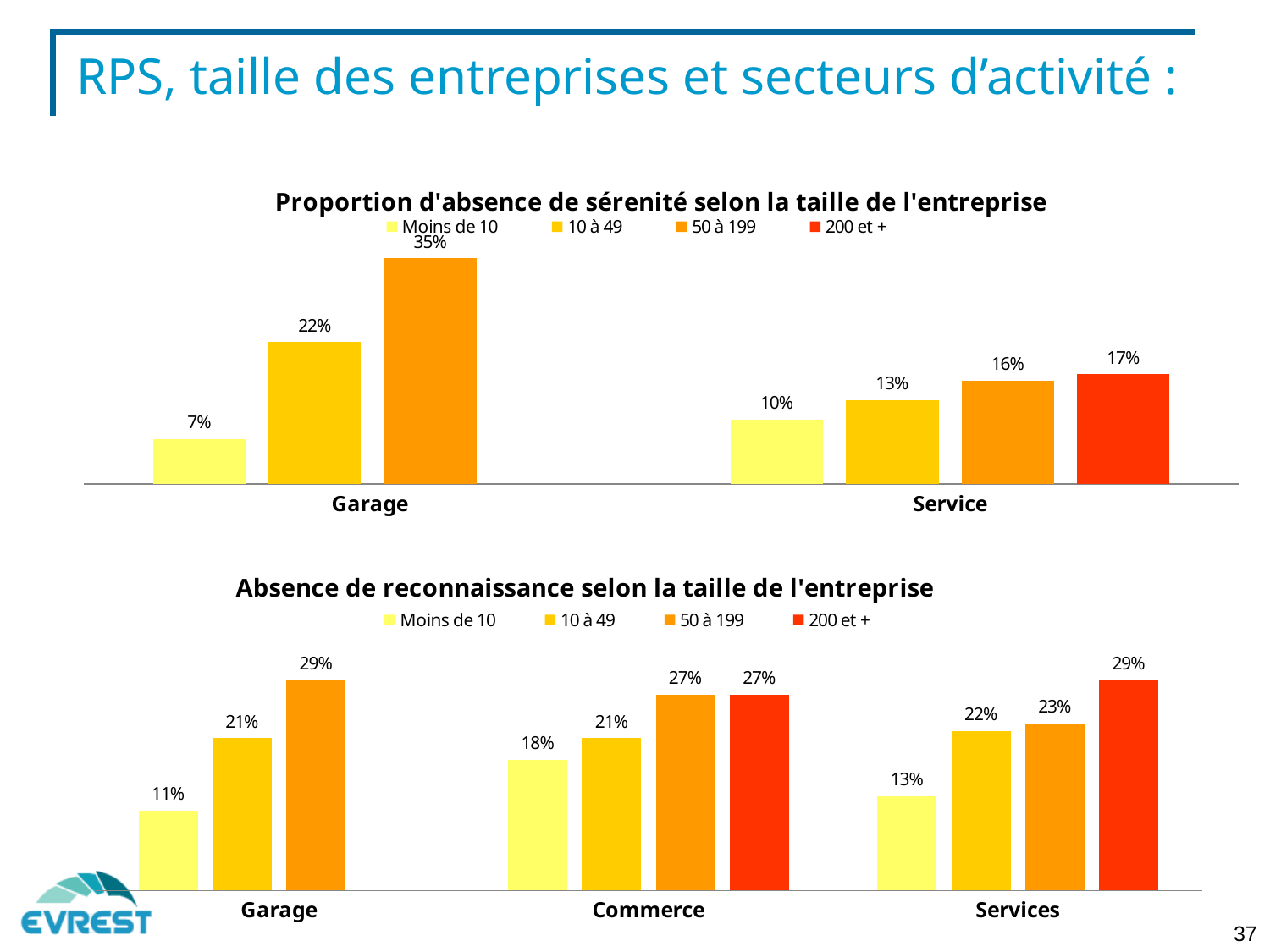
In the chart 'Absence de reconnaissance selon la taille de l'entreprise', what is the value for 'Moins de 10' in the Commerce category? 18% In the chart 'Absence de reconnaissance selon la taille de l'entreprise', what is the value for '200 et +' in the Services category? 29% In the chart 'Proportion d'absence de sérenité selon la taille de l'entreprise', what is the value for '50 à 199' in the Garage category? 35% In the chart 'Absence de reconnaissance selon la taille de l'entreprise', is the '50 à 199' value for Garage larger or smaller than the '50 à 199' value for Services? larger In the chart 'Proportion d'absence de sérenité selon la taille de l'entreprise', what is the value for '200 et +' in the Service category? 17% In the chart 'Proportion d'absence de sérenité selon la taille de l'entreprise', what is the difference between the '10 à 49' values for Garage and Service? 9% How many categories are shown on the x axis of the chart 'Absence de reconnaissance selon la taille de l'entreprise'? 3 What kind of chart is the bottom chart on the slide? Bar chart How many series does the legend of the chart 'Proportion d'absence de sérenité selon la taille de l'entreprise' list? 4 In the chart 'Proportion d'absence de sérenité selon la taille de l'entreprise', which category has the lowest value for 'Moins de 10'? Garage In the chart 'Absence de reconnaissance selon la taille de l'entreprise', which category has the highest value for 'Moins de 10'? Commerce In the chart 'Absence de reconnaissance selon la taille de l'entreprise', what is the difference between the '10 à 49' and 'Moins de 10' values for Services? 9%